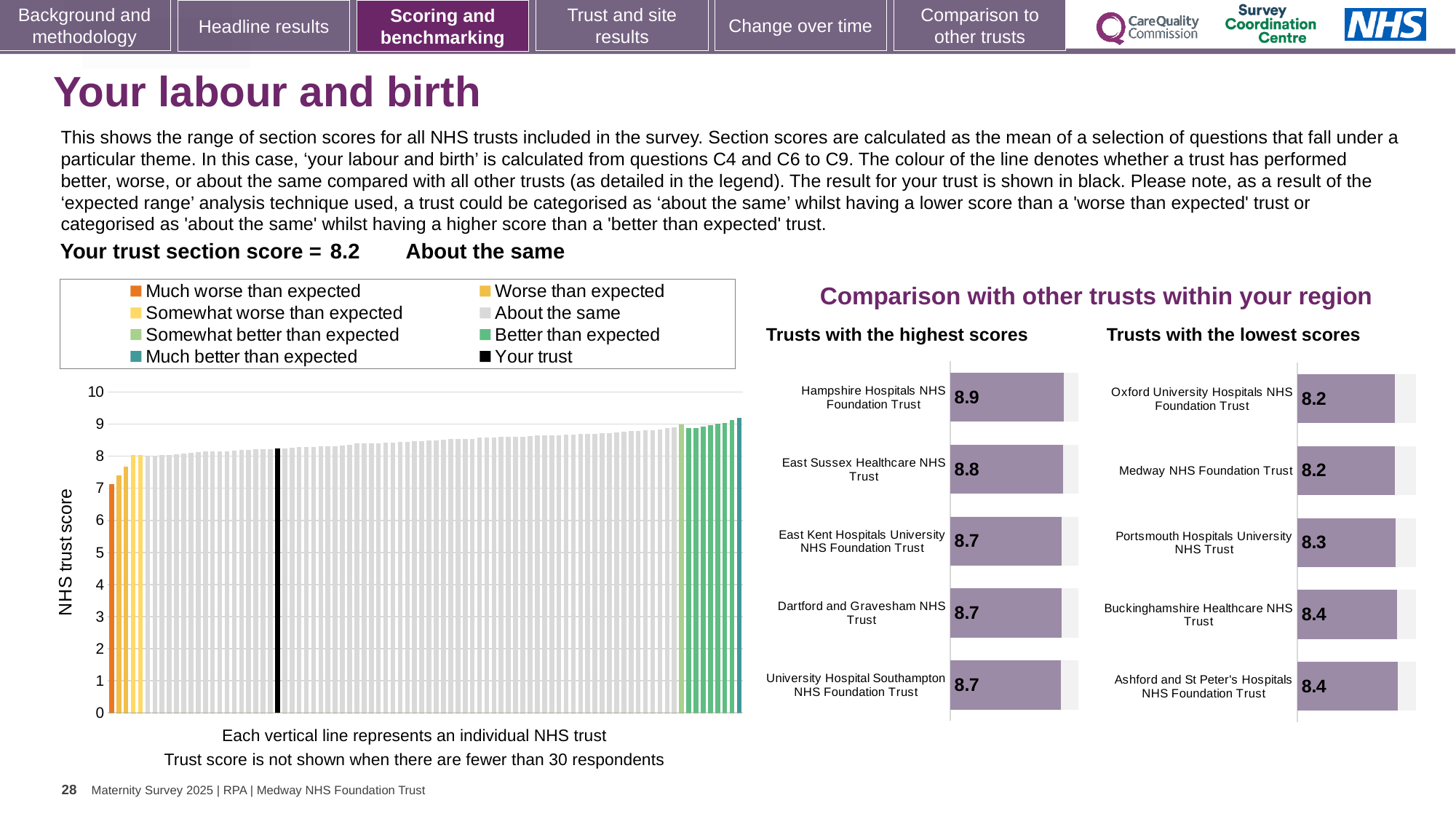
In the 'Trusts with the highest scores' chart, which has the larger score: East Sussex Healthcare NHS Trust or Dartford and Gravesham NHS Trust? East Sussex Healthcare NHS Trust In the 'Trusts with the lowest scores' chart, what is the score for Portsmouth Hospitals University NHS Trust? 8.3 In the main 'NHS trust score' chart, is the value of the black 'Your trust' bar greater or less than 5? greater In the 'Trusts with the highest scores' chart, what is the difference between the scores of Hampshire Hospitals NHS Foundation Trust and East Sussex Healthcare NHS Trust? 0.1 In the main 'NHS trust score' chart, do the values rise or fall from left to right? Rise In the 'Trusts with the highest scores' chart, what is the score for Hampshire Hospitals NHS Foundation Trust? 8.9 How many entries does the legend of the main 'NHS trust score' chart list? 8 In the 'Trusts with the highest scores' chart, which trust has the highest score? Hampshire Hospitals NHS Foundation Trust How many trusts are shown in the 'Trusts with the lowest scores' chart? 5 What is the label on the vertical axis of the main chart on the left? NHS trust score In the 'Trusts with the lowest scores' chart, what is the difference between the scores of Ashford and St Peter's Hospitals NHS Foundation Trust and Oxford University Hospitals NHS Foundation Trust? 0.2 What kind of chart is the main 'NHS trust score' chart on the left? Bar chart